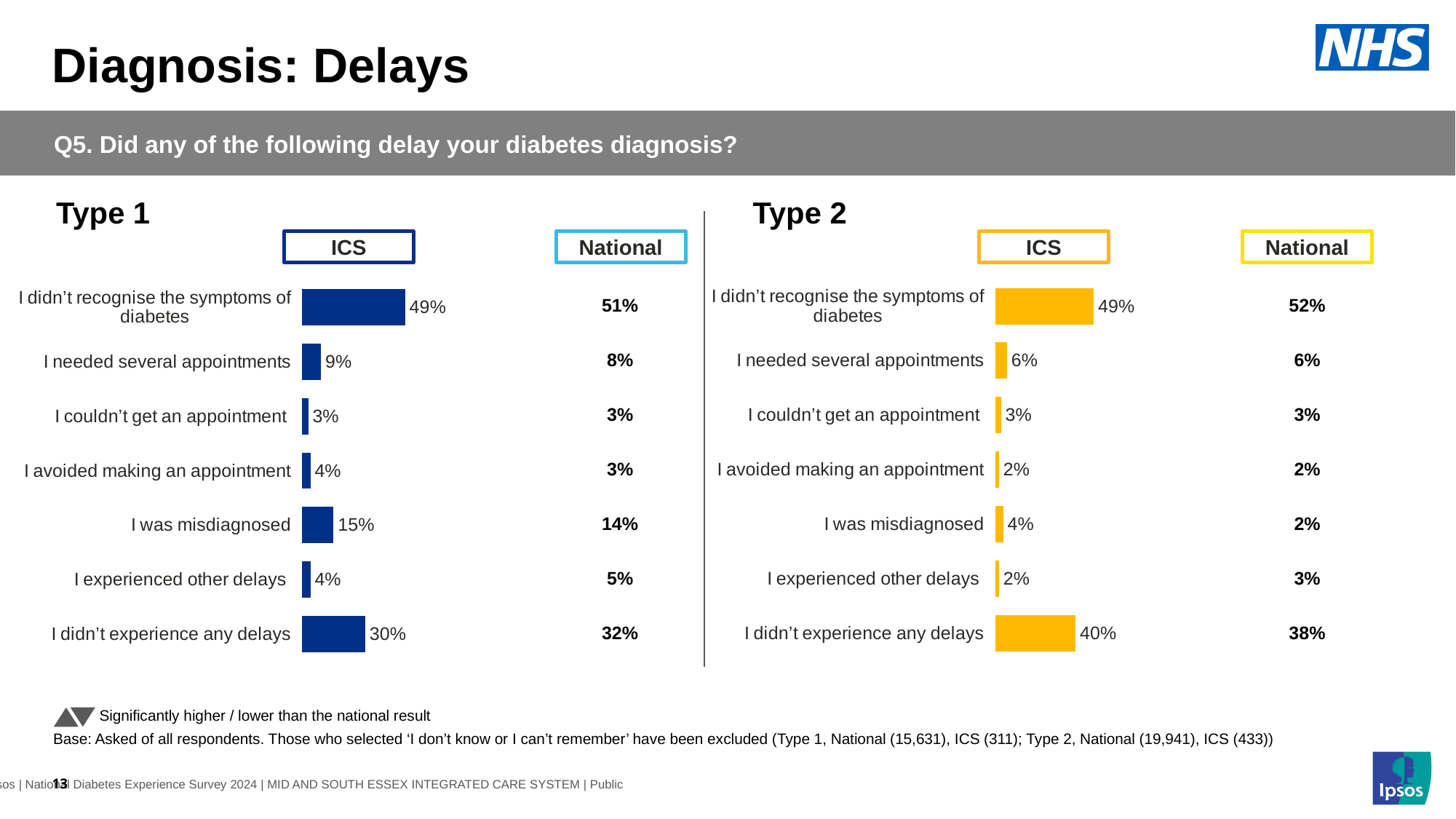
What colour are the ICS bars in the Type 2 chart? Yellow/orange In the Type 2 chart, what is the National value for 'I didn't recognise the symptoms of diabetes'? 52% In the Type 1 chart, what is the difference between the ICS and National values for 'I didn't experience any delays'? 2 percentage points In the Type 2 chart, which category has the lowest National value? I avoided making an appointment and I was misdiagnosed (both 2%) In the Type 1 chart, what is the ICS value for 'I didn't recognise the symptoms of diabetes'? 49% In the Type 2 chart, what is the ICS value for 'I didn't experience any delays'? 40% In the Type 1 chart, what is the National value for 'I was misdiagnosed'? 14% What type of chart is used for the ICS values in the Type 2 chart? Bar chart How many categories are shown in the Type 1 chart? 7 In the Type 1 chart, which category has the highest ICS value? I didn't recognise the symptoms of diabetes In the Type 2 chart, which is larger for 'I was misdiagnosed': the ICS value or the National value? ICS In the Type 1 chart, what is the ICS value for 'I needed several appointments'? 9%